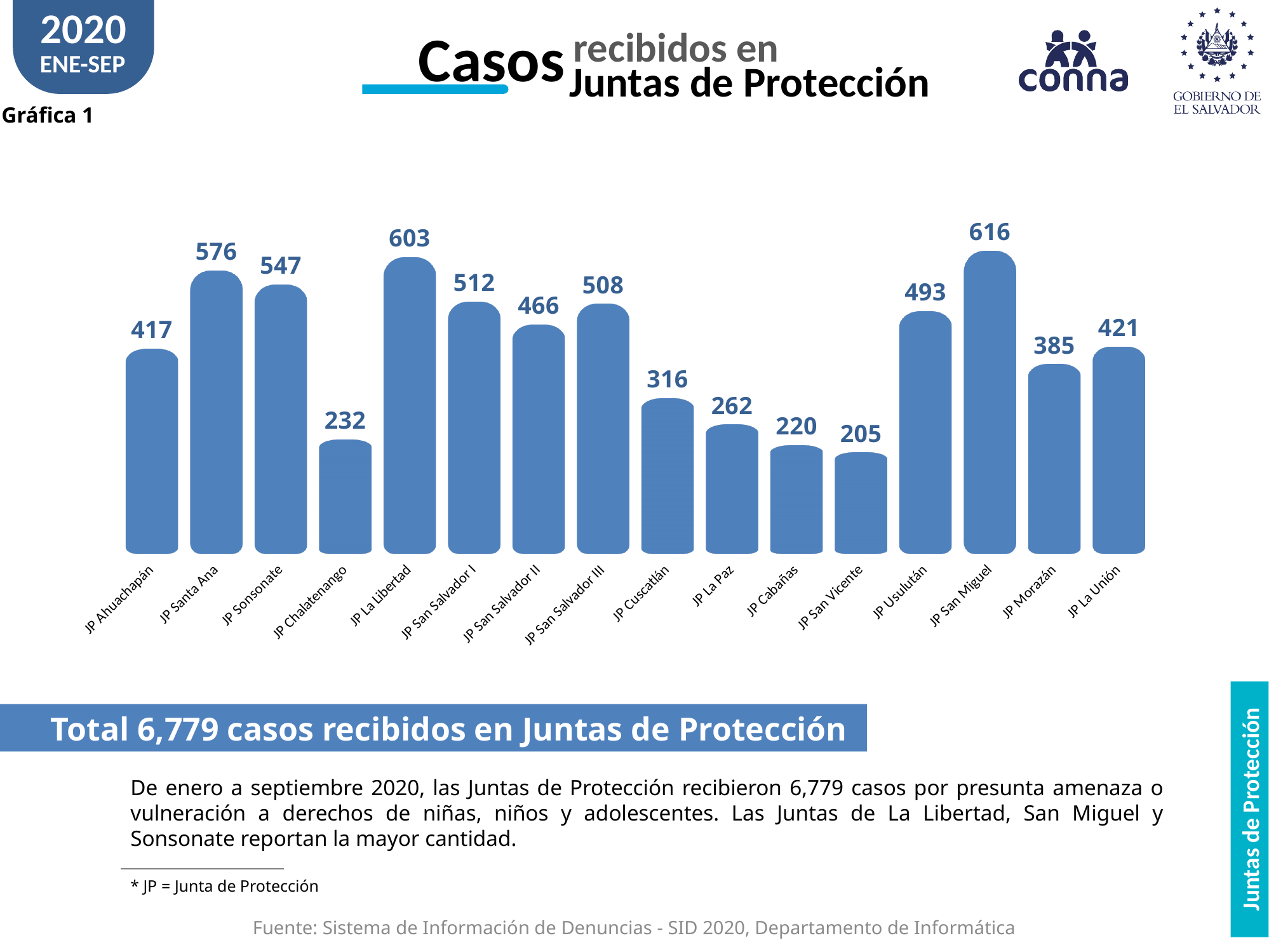
Which Junta de Protección has the highest number of cases? JP San Miguel What type of chart is shown on the slide? Bar chart What is the value shown for JP Cuscatlán? 316 How many cases were received by JP La Libertad? 603 Which has a larger value, JP Ahuachapán or JP La Unión? JP La Unión How many Juntas de Protección are shown on the chart? 16 Which Junta de Protección has the lowest number of cases? JP San Vicente What is the value shown for JP Morazán? 385 What total number of cases is stated on the slide? 6,779 What is the difference between the values for JP Santa Ana and JP Sonsonate? 29 Which has a larger value, JP San Salvador I or JP San Salvador III? JP San Salvador I What is the difference between the values for JP San Miguel and JP San Vicente? 411